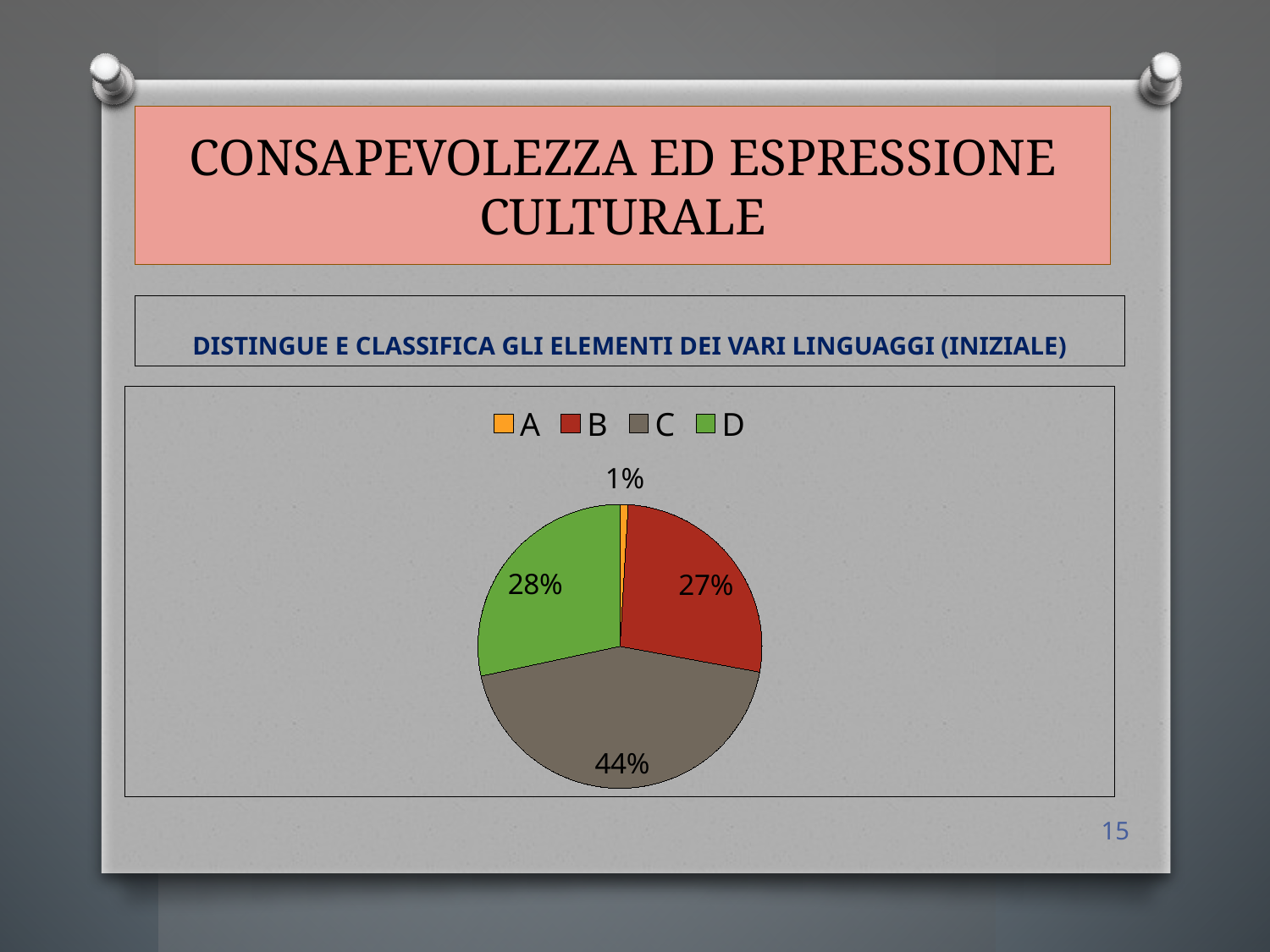
What is the combined share of slices B and D? 55% What type of chart is shown on the slide? pie chart What percentage does slice B represent? 27% What percentage does slice D represent? 28% How many categories does the legend list? 4 What colour is the slice for category D? green Which category has the largest share of the pie? C What percentage does slice C represent? 44% What percentage does slice A represent? 1% Which category has the smallest share of the pie? A Which is larger, the share for B or the share for C? C What is the difference in percentage points between slice C and slice D? 16